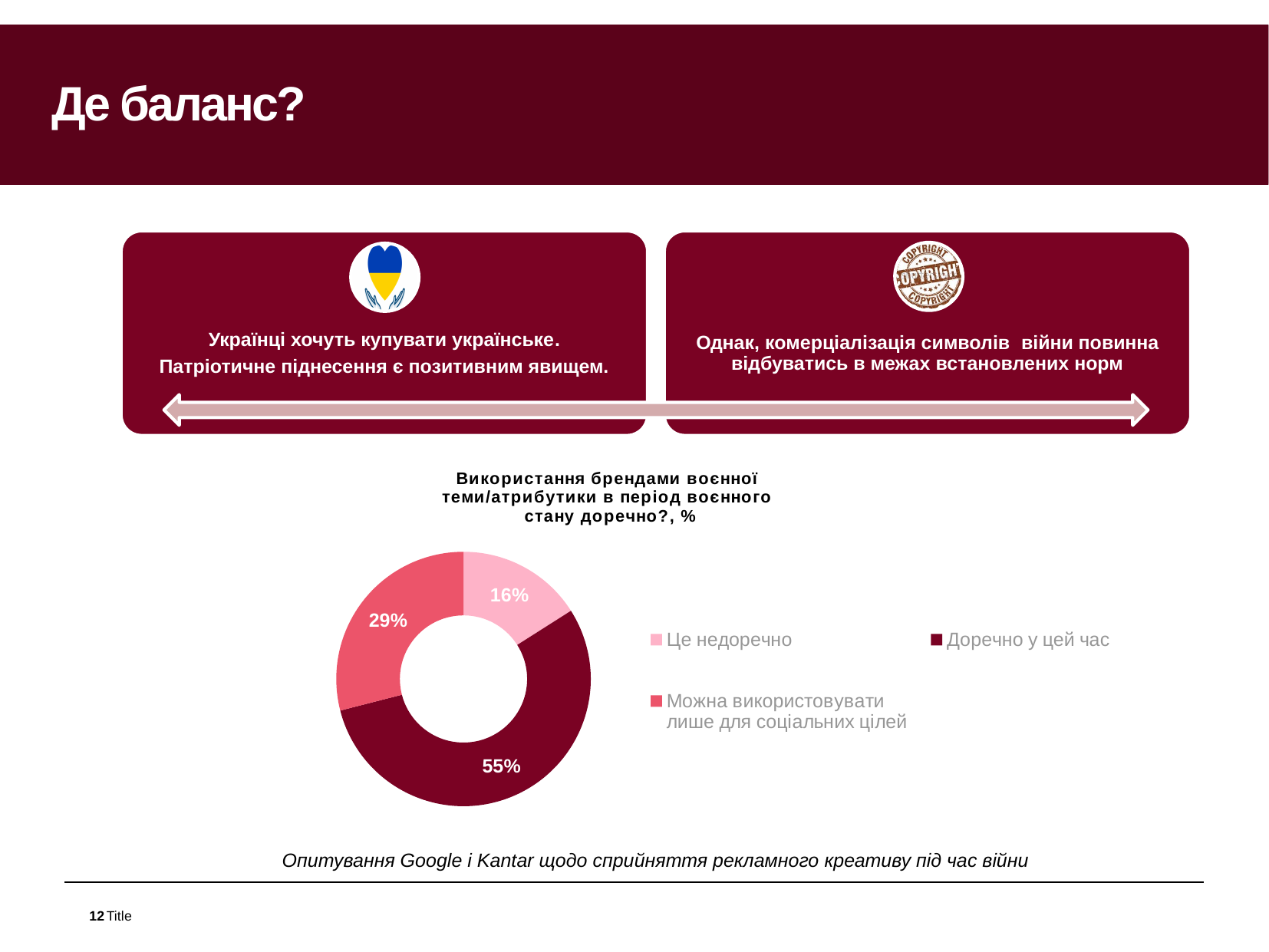
How many categories does the chart show? 3 Which category has the smallest share of the chart? Це недоречно Which is larger: the share for "Можна використовувати лише для соціальних цілей" or the share for "Це недоречно"? Можна використовувати лише для соціальних цілей What is the difference between the shares for "Доречно у цей час" and "Це недоречно"? 39% Which category has the largest share of the chart? Доречно у цей час What kind of chart is shown on the slide? Donut (pie) chart What is the value for "Доречно у цей час"? 55% What is the value for "Це недоречно"? 16% What is the difference between the shares for "Можна використовувати лише для соціальних цілей" and "Це недоречно"? 13% Which category is shown in the darkest (maroon) colour? Доречно у цей час What is the value for "Можна використовувати лише для соціальних цілей"? 29% What is the title of the chart? Використання брендами воєнної теми/атрибутики в період воєнного стану доречно?, %